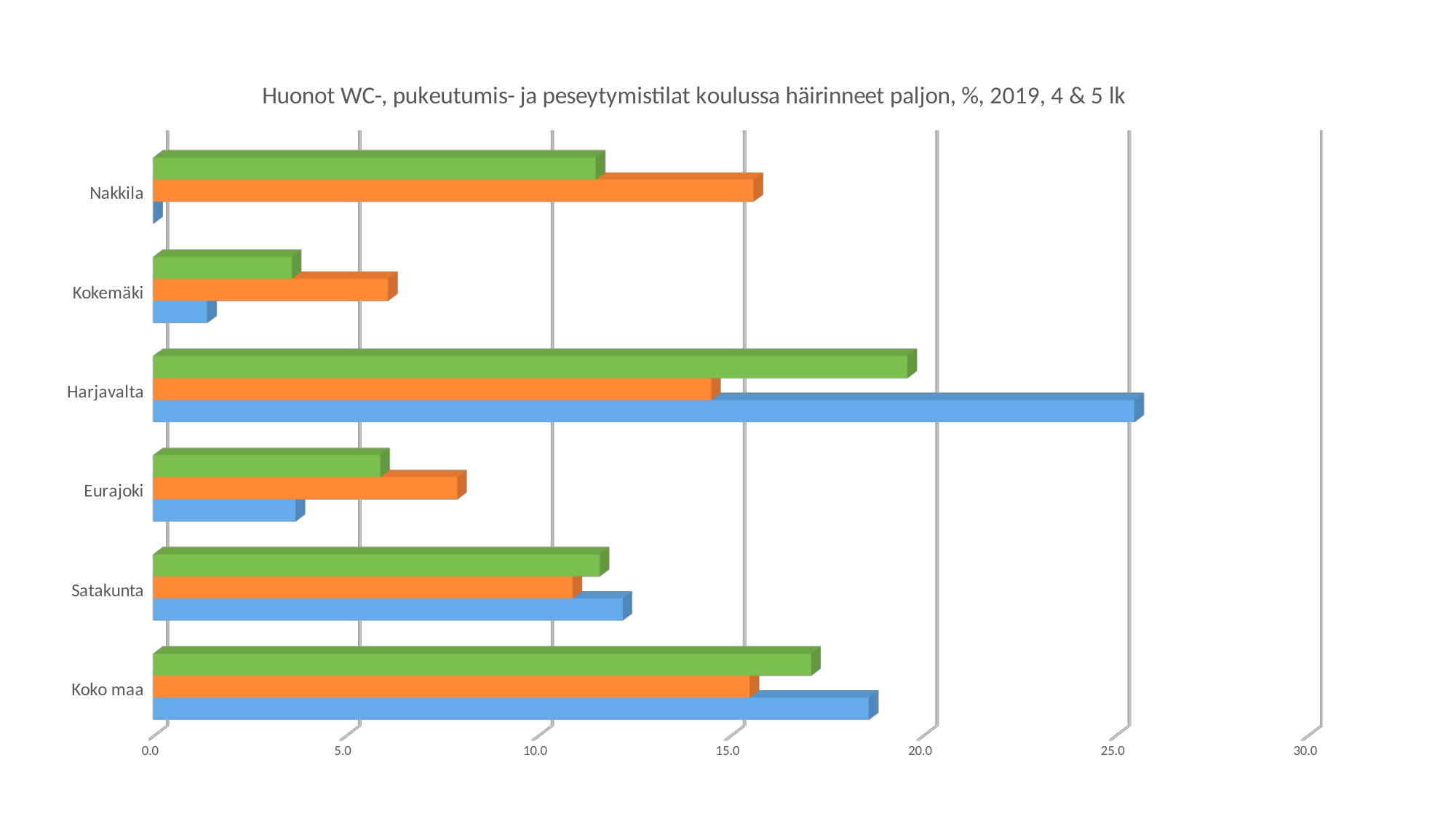
Which category has the shortest blue bar? Nakkila How many categories are shown on the vertical axis of the chart? 6 What kind of chart is shown on the slide? bar chart Is the green bar for Koko maa greater or less than 15.0? greater How many bars are plotted for each category in the chart? 3 What is the title of the chart? Huonot WC-, pukeutumis- ja peseytymistilat koulussa häirinneet paljon, %, 2019, 4 & 5 lk Which has the longer blue bar, Harjavalta or Koko maa? Harjavalta Is the blue bar for Harjavalta greater or less than 20.0? greater Which category has the shortest orange bar? Kokemäki Which category has the longest green bar? Harjavalta Which category has the longest blue bar? Harjavalta Is the green bar for Kokemäki greater or less than 5.0? less